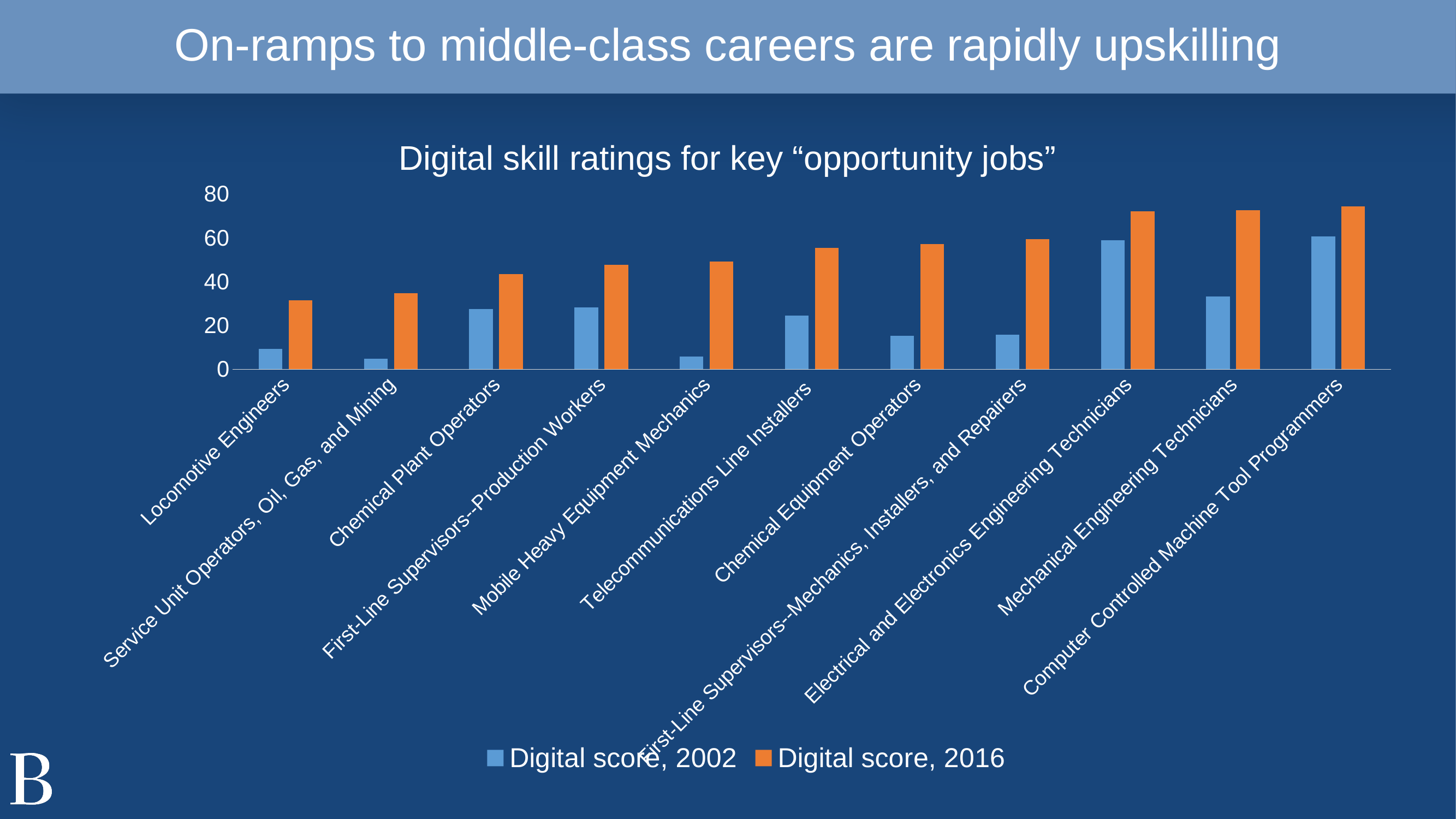
Which job has the lowest Digital score, 2016 value? Locomotive Engineers Is the Digital score, 2016 value for Locomotive Engineers greater or less than 20? greater Is the Digital score, 2002 value for Mechanical Engineering Technicians greater or less than 40? less What is the title of the chart? Digital skill ratings for key "opportunity jobs" Is the Digital score, 2016 value for Computer Controlled Machine Tool Programmers greater or less than 60? greater How many series does the chart legend list? 2 Which is larger for Telecommunications Line Installers: the Digital score, 2002 or the Digital score, 2016? Digital score, 2016 Do the Digital score, 2016 values generally rise or fall moving left to right along the x axis? rise What kind of chart is shown on the slide? bar chart How many job categories are shown on the x axis of the chart? 11 Which series is shown in orange in the chart? Digital score, 2016